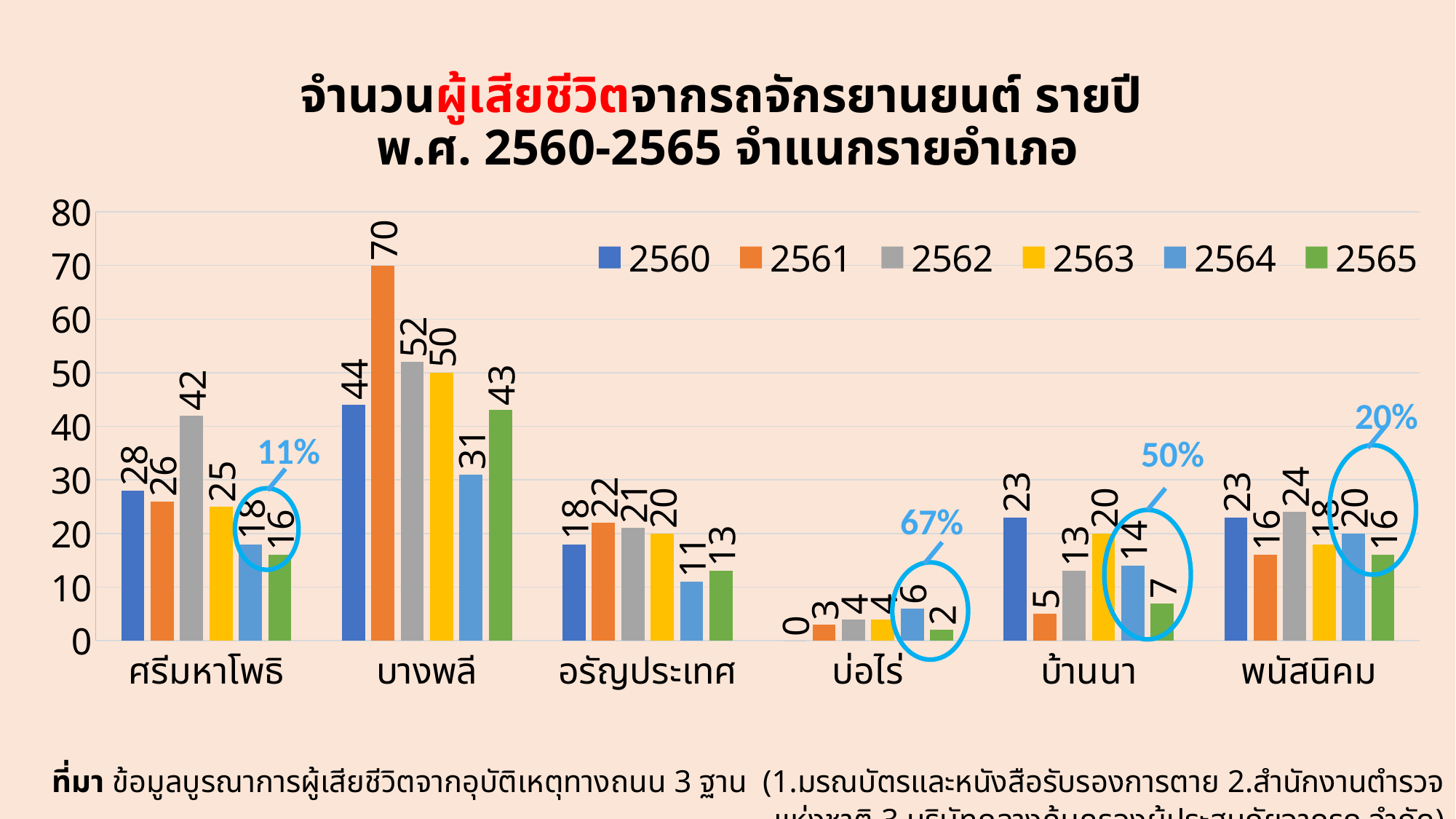
What is the value for บางพลี in 2561? 70 Which is larger for พนัสนิคม: the 2562 value or the 2564 value? 2562 Is the value for บางพลี in 2563 greater or less than 40? greater What is the value for บ้านนา in 2565? 7 What type of chart is shown on the slide? bar chart Which district has the highest value in 2561? บางพลี What is the difference between the 2561 and 2565 values for บางพลี? 27 Which district has the lowest value in 2560? บ่อไร่ What percentage is annotated next to the circled bars for บ่อไร่? 67% How many series does the legend list? 6 How many districts (categories) are shown on the x axis? 6 What is the value for ศรีมหาโพธิ in 2562? 42